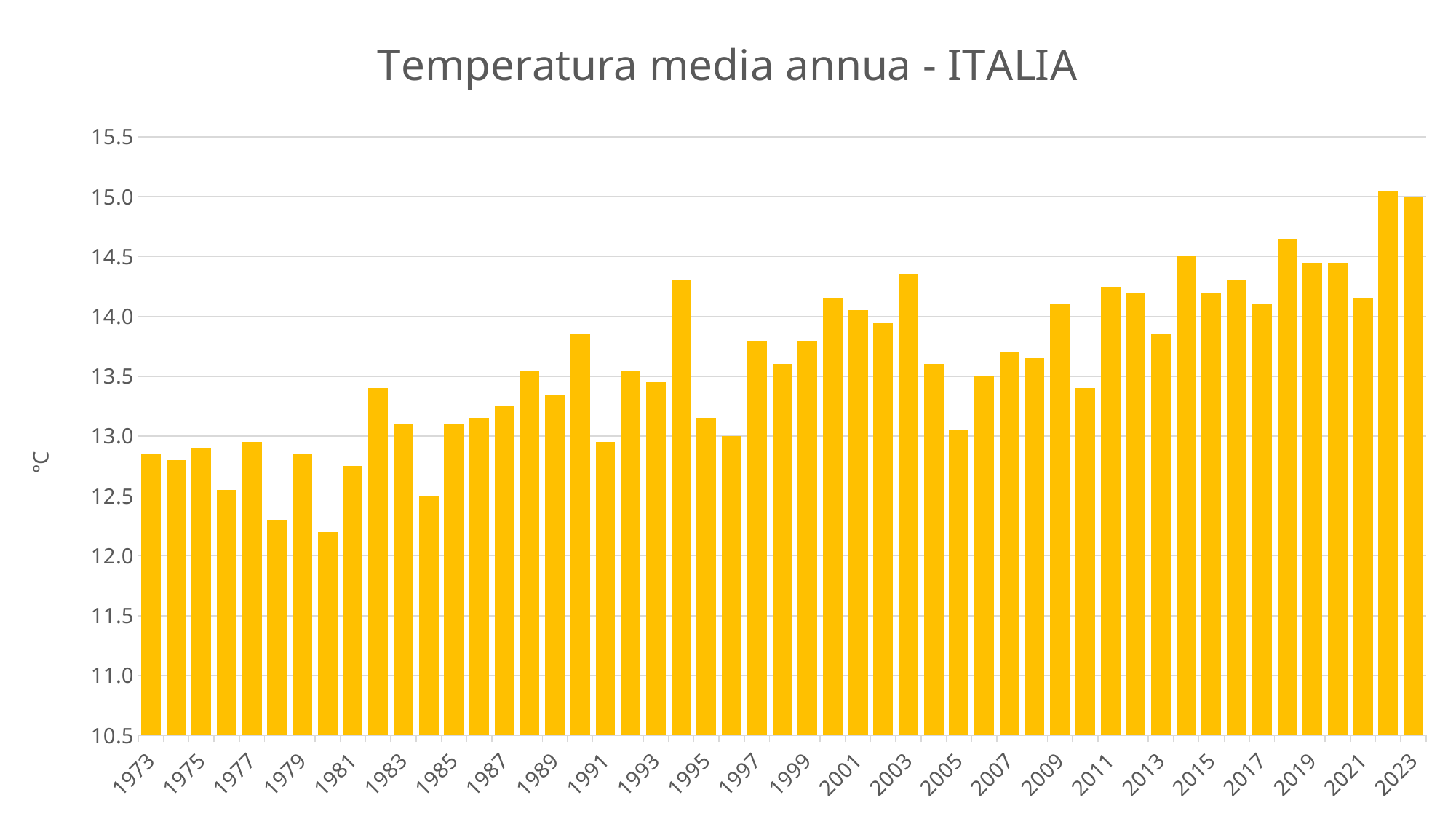
Is the value for 1984 greater or less than 13.0? less Which year has the lowest bar in the chart? 1980 Is the value for 2010 greater or less than 13.5? less What is the title of the chart? Temperatura media annua - ITALIA Is the value for 1994 greater or less than 14.0? greater What unit is shown on the vertical axis label? °C Which is larger, the value for 1980 or the value for 1982? 1982 Overall, do the values rise or fall from 1973 to 2023? rise What kind of chart is shown on the slide? bar chart Which is larger, the value for 1994 or the value for 1995? 1994 Which is larger, the value for 2003 or the value for 2004? 2003